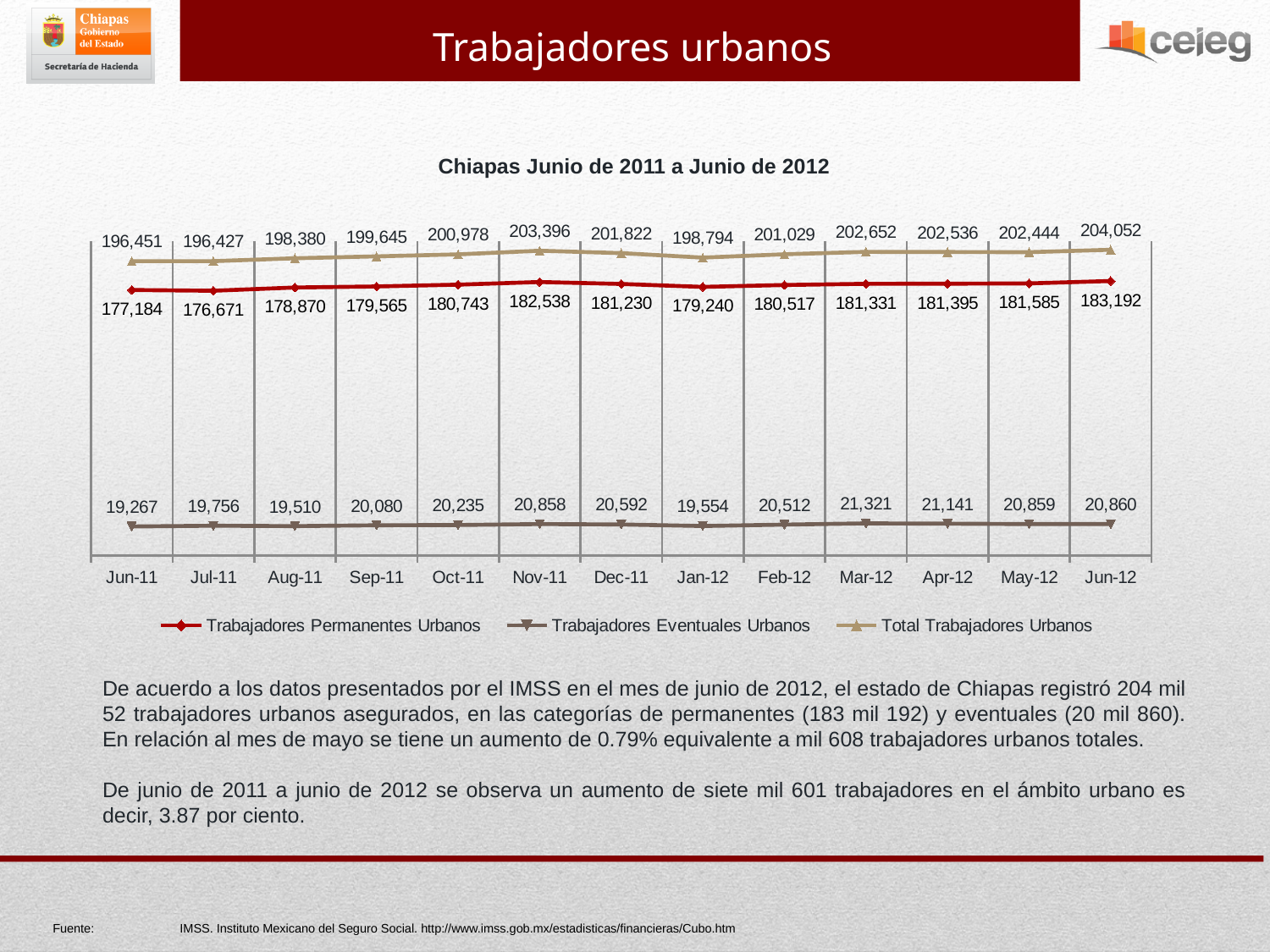
How many series does the legend list? 3 What is the difference between Total Trabajadores Urbanos in Jun-12 and Jun-11? 7,601 In which month is Total Trabajadores Urbanos highest? Jun-12 Which is larger: Trabajadores Eventuales Urbanos in Mar-12 or in Apr-12? Mar-12 What is the value of Trabajadores Permanentes Urbanos for Nov-11? 182,538 What is the value of Total Trabajadores Urbanos for Jun-12? 204,052 What is the title of the chart? Chiapas Junio de 2011 a Junio de 2012 What type of chart is shown on the slide? Line chart How many months are plotted along the x axis? 13 In which month is Trabajadores Permanentes Urbanos lowest? Jul-11 What is the value of Trabajadores Eventuales Urbanos for Jan-12? 19,554 In which month is Trabajadores Eventuales Urbanos lowest? Jun-11